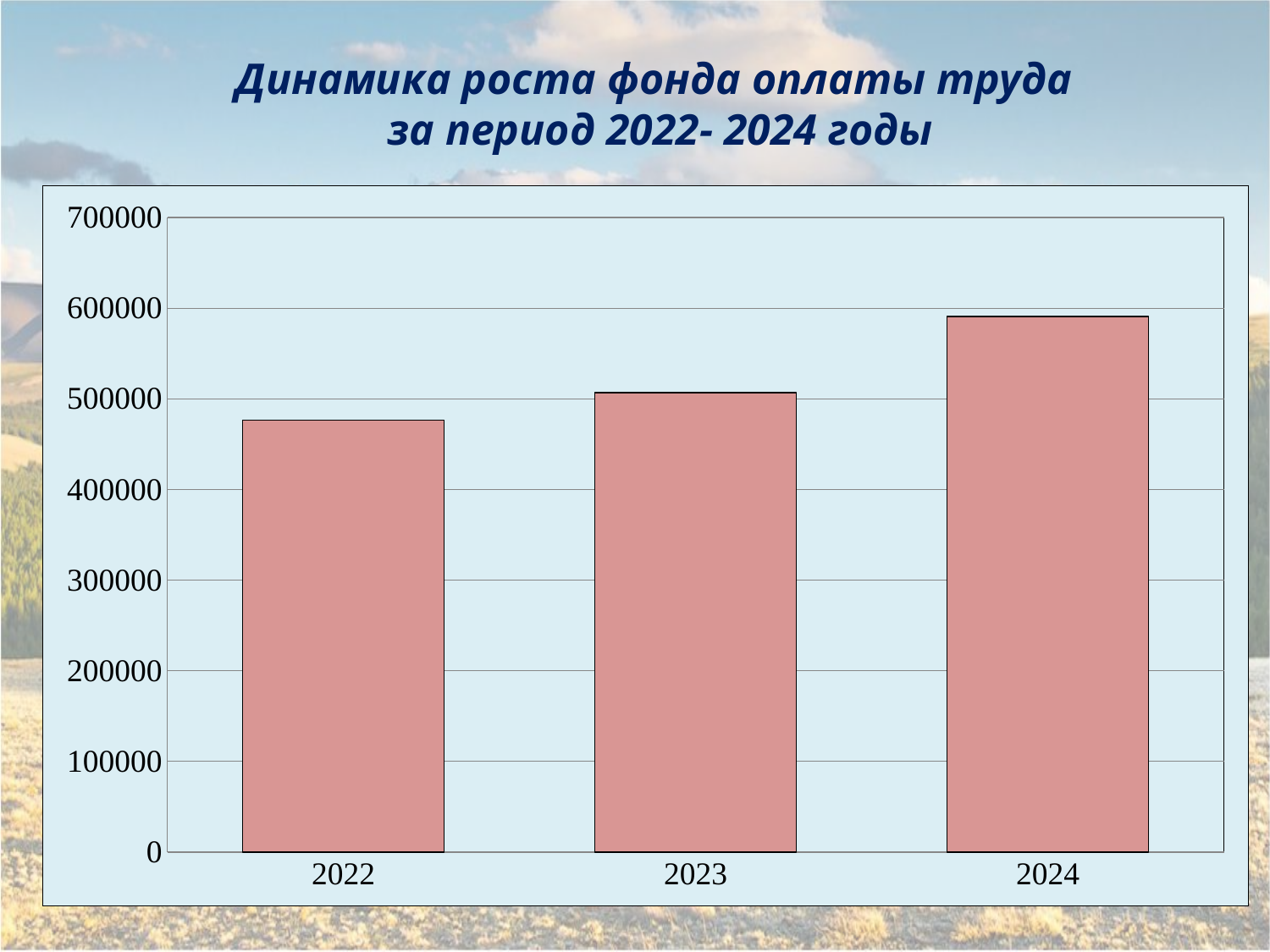
How many years (categories) are shown on the x axis? 3 What kind of chart is shown on the slide? bar chart Which year has the lowest value? 2022 Is the value for 2023 greater or less than 400000? greater Is the value for 2022 greater or less than 500000? less Which is larger, the value for 2022 or the value for 2024? 2024 Is the value for 2024 greater or less than 600000? less What is the title of the slide above the chart? Динамика роста фонда оплаты труда за период 2022- 2024 годы Do the values rise or fall from 2022 to 2024? rise Which is larger, the value for 2022 or the value for 2023? 2023 Which year has the highest value? 2024